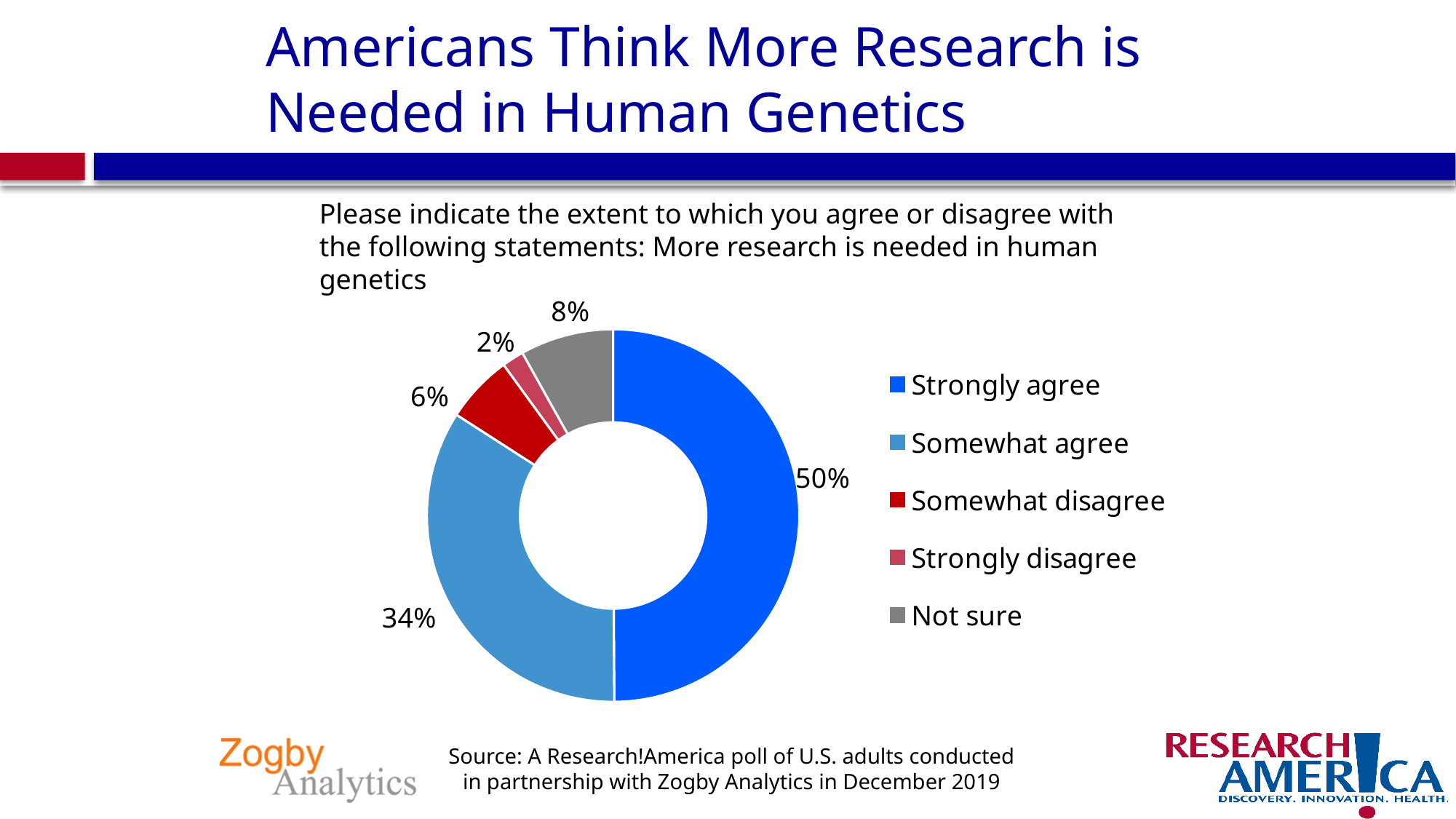
What is the difference in percentage points between Strongly agree and Somewhat agree? 16 What percentage of respondents are not sure? 8% Which is larger, the share for Not sure or the share for Somewhat disagree? Not sure What percentage of respondents somewhat agree? 34% What percentage of respondents strongly agree that more research is needed in human genetics? 50% What percentage of respondents somewhat disagree? 6% What percentage of respondents strongly disagree? 2% Which response category has the largest share? Strongly agree Which response category has the smallest share? Strongly disagree What colour represents the Not sure category? Gray What kind of chart is shown on the slide? Doughnut (pie) chart How many response categories does the chart show? 5